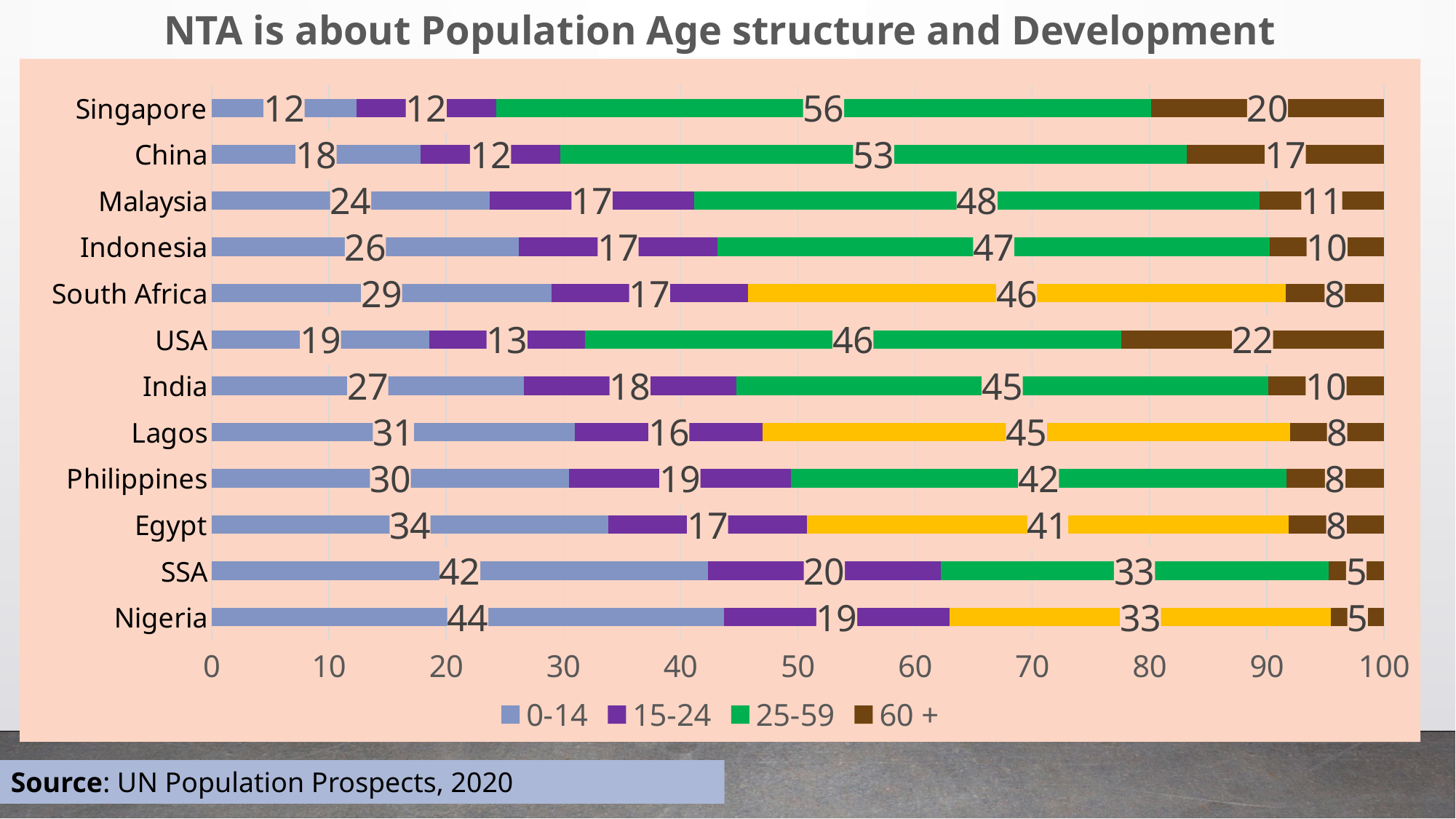
What kind of chart is shown on the slide? Stacked bar chart What is the value for the 15-24 age group in the Philippines? 19 Which country has the highest value for the 60 + age group? USA Which is larger, the 25-59 value for Malaysia or for India? Malaysia What is the difference between the 0-14 values for Egypt and China? 16 What is the value for the 60 + age group in the USA? 22 What is the value for the 25-59 age group in Singapore? 56 Which country has the lowest value for the 0-14 age group? Singapore How many countries or regions are shown on the chart? 12 How many age groups does the legend list? 4 What is the value for the 0-14 age group in Nigeria? 44 Which country has the highest value for the 0-14 age group? Nigeria